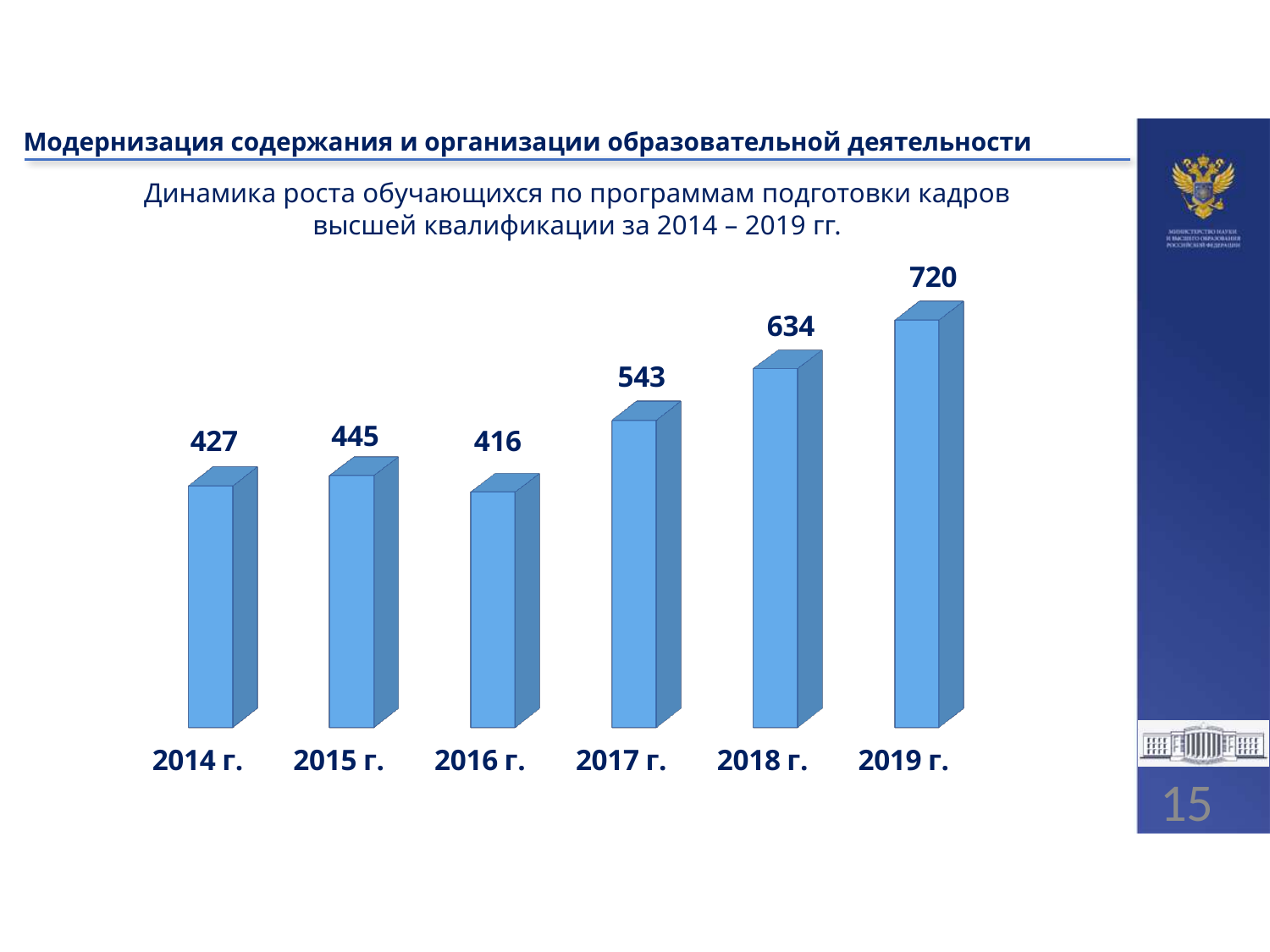
What kind of chart is shown on the slide? bar chart What is the value for 2019 г.? 720 What is the title of the chart? Динамика роста обучающихся по программам подготовки кадров высшей квалификации за 2014 – 2019 гг. How many years are shown on the chart? 6 Do the values generally rise or fall from 2016 г. to 2019 г.? rise What is the value for 2017 г.? 543 What is the difference between the values for 2015 г. and 2014 г.? 18 What is the value for 2014 г.? 427 What is the difference between the values for 2019 г. and 2018 г.? 86 Which year has the lowest value? 2016 г. Which year has the highest value? 2019 г. Which is larger, the value for 2015 г. or the value for 2016 г.? 2015 г.